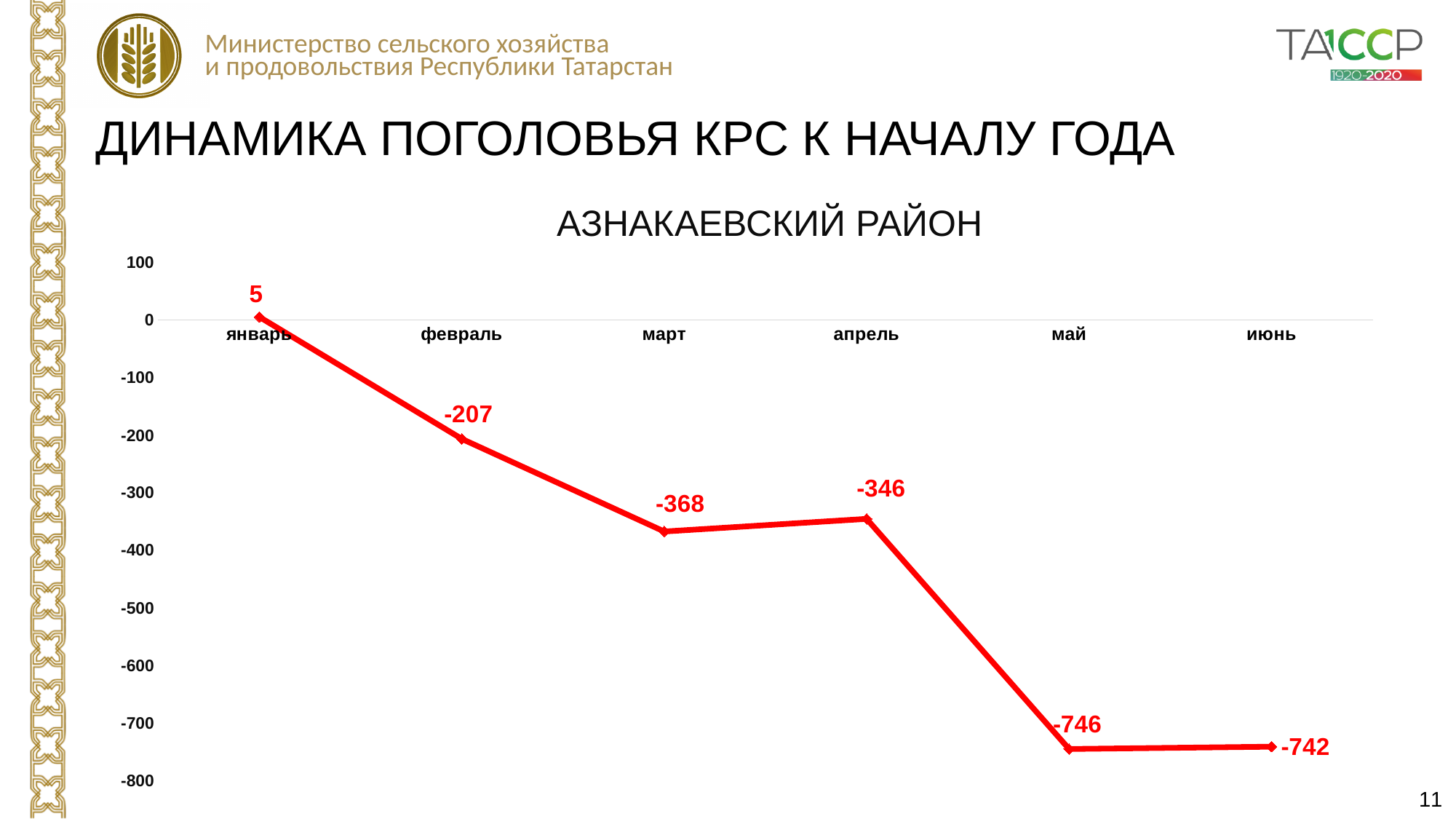
How many months are plotted on the chart? 6 What kind of chart is shown on the slide? line chart What is the value for июнь? -742 Which month has the lowest value? май Which month has the highest value? январь Which is larger, the value for февраль or the value for март? февраль What is the value for февраль? -207 What is the value for апрель? -346 What is the difference between the values for март and апрель? 22 What is the value for январь? 5 What is the title of the chart? АЗНАКАЕВСКИЙ РАЙОН Is the value for май greater or less than -700? less